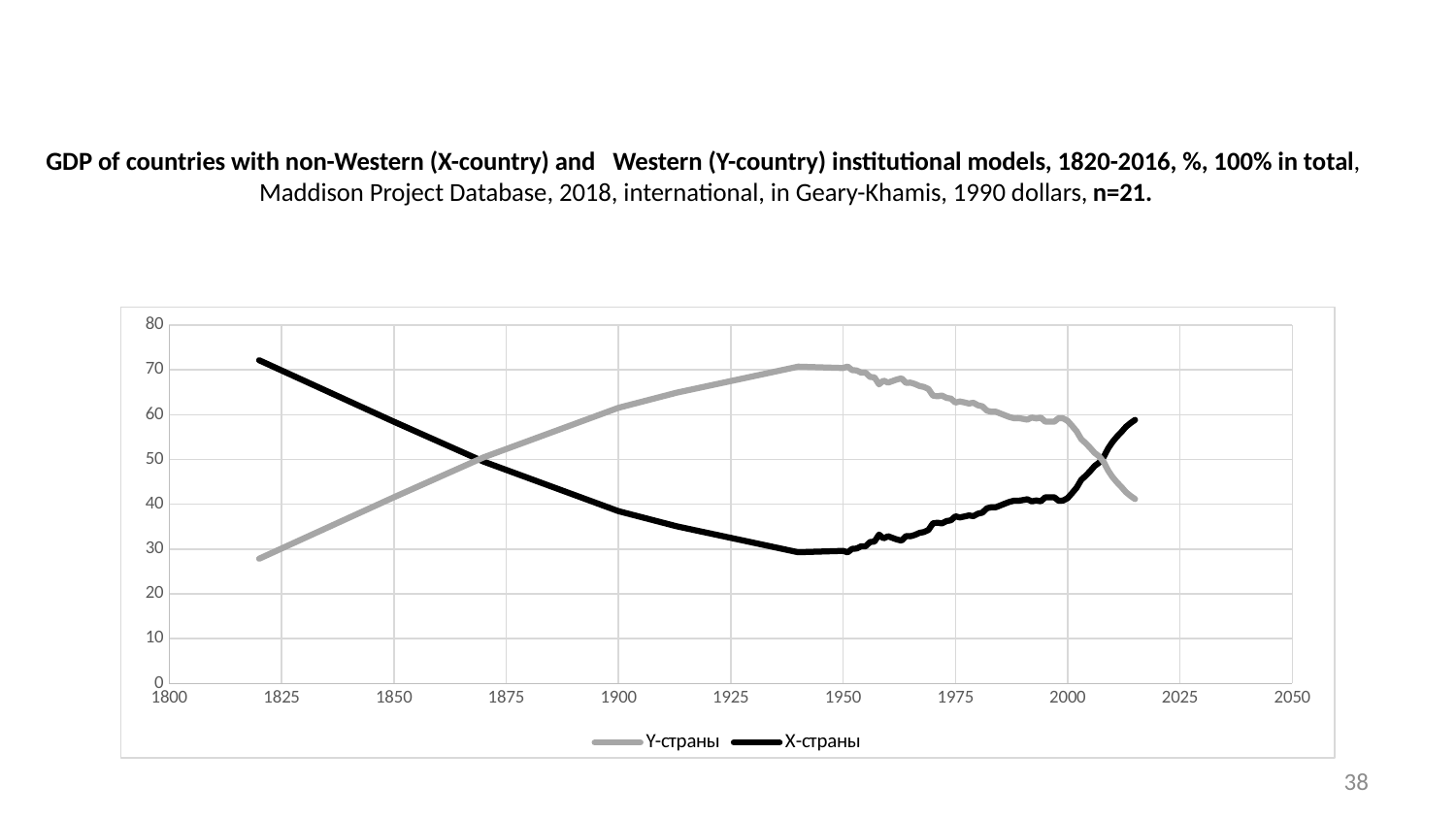
Is the value for Y-страны in 1820 greater or less than 40? less How many series does the legend list? 2 What kind of chart is shown on the slide? line chart Which series has the higher value around 1950, Y-страны or X-страны? Y-страны Is the value for X-страны around 1950 greater or less than 40? less What are the two series named in the legend? Y-страны and X-страны Which series has the higher value in 1820, Y-страны or X-страны? X-страны What colour is the line for X-страны? black Is the value for Y-страны around 1940 greater or less than 60? greater Does the X-страны line rise or fall between 1820 and 1950? fall